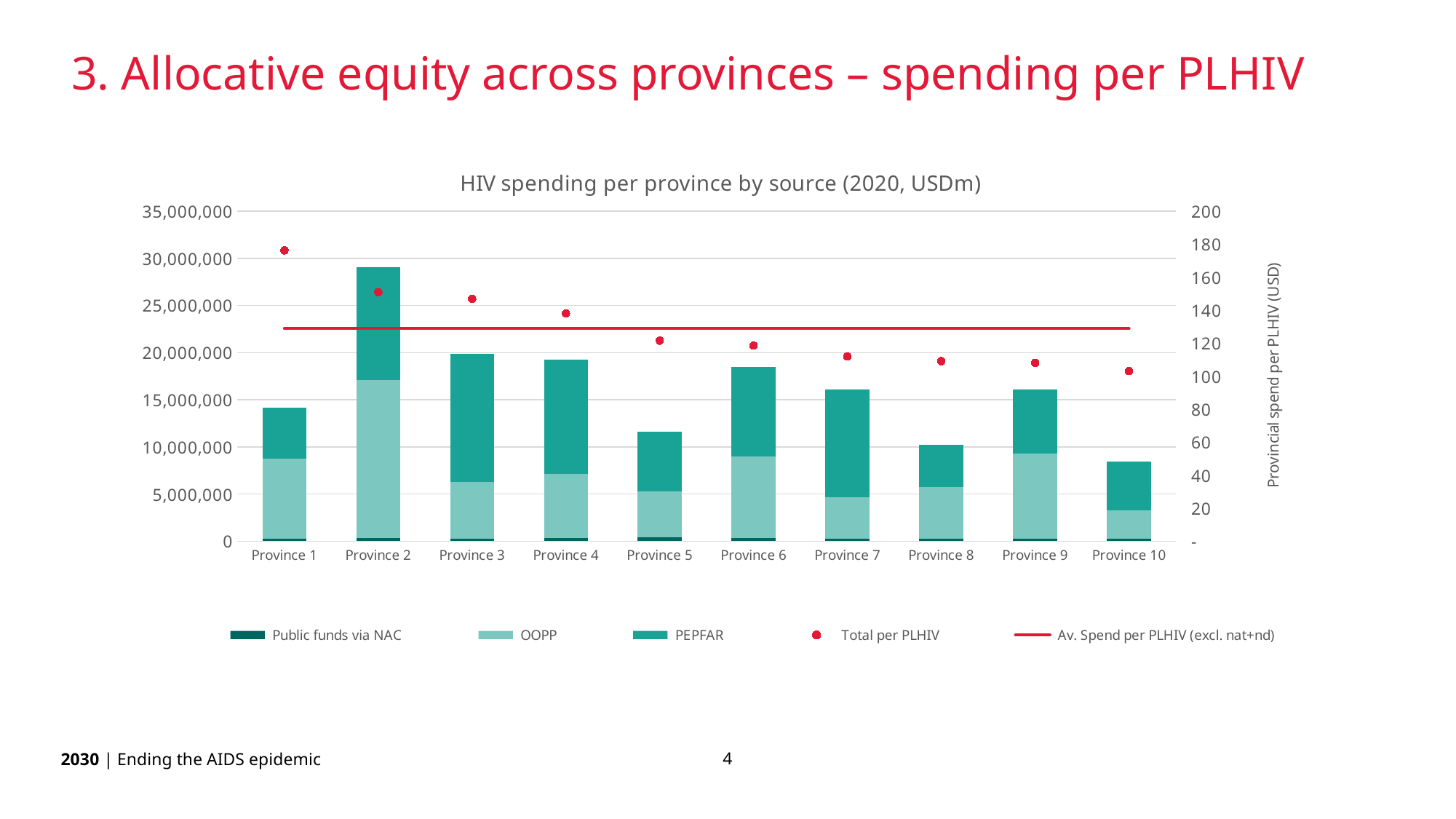
Which province has the lowest Total per PLHIV marker? Province 10 What is the title of the chart? HIV spending per province by source (2020, USDm) Which province has the shortest stacked bar for total HIV spending? Province 10 How many series does the chart's legend list? 5 What kind of chart is used to show HIV spending per province by source? bar chart Is the Total per PLHIV value for Province 1 greater or less than 160? greater Which has the larger total stacked bar, Province 3 or Province 5? Province 3 Which province has the highest Total per PLHIV marker? Province 1 Is the total stacked bar for Province 2 greater or less than 25,000,000? greater Do the Total per PLHIV markers generally rise or fall from Province 1 to Province 10? fall How many provinces are shown on the x axis of the chart? 10 Which province has the tallest stacked bar for total HIV spending? Province 2